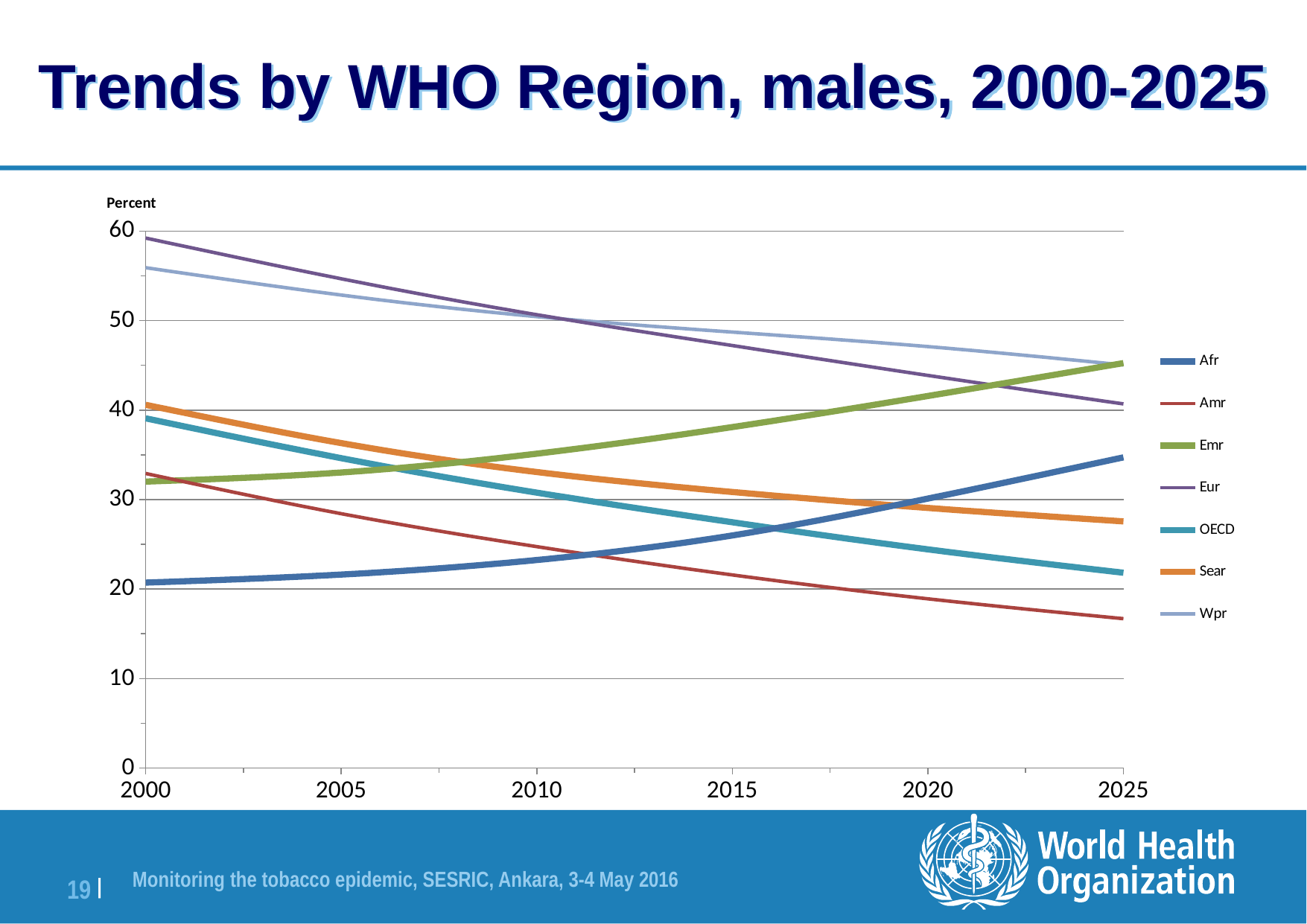
Which region has the highest value in 2000? Eur What label is shown on the vertical axis of the chart? Percent How many series does the legend list? 7 Does the Emr line rise or fall from 2000 to 2025? rise What kind of chart is shown on the slide? line chart Is the value for Amr in 2025 greater or less than 20? less Is the value for Eur in 2000 greater or less than 50? greater Which region has the lowest value in 2025? Amr Does the Afr line rise or fall from 2000 to 2025? rise In 2025, which is larger, the value for Afr or the value for Amr? Afr Does the Eur line rise or fall from 2000 to 2025? fall Which region has the lowest value in 2000? Afr